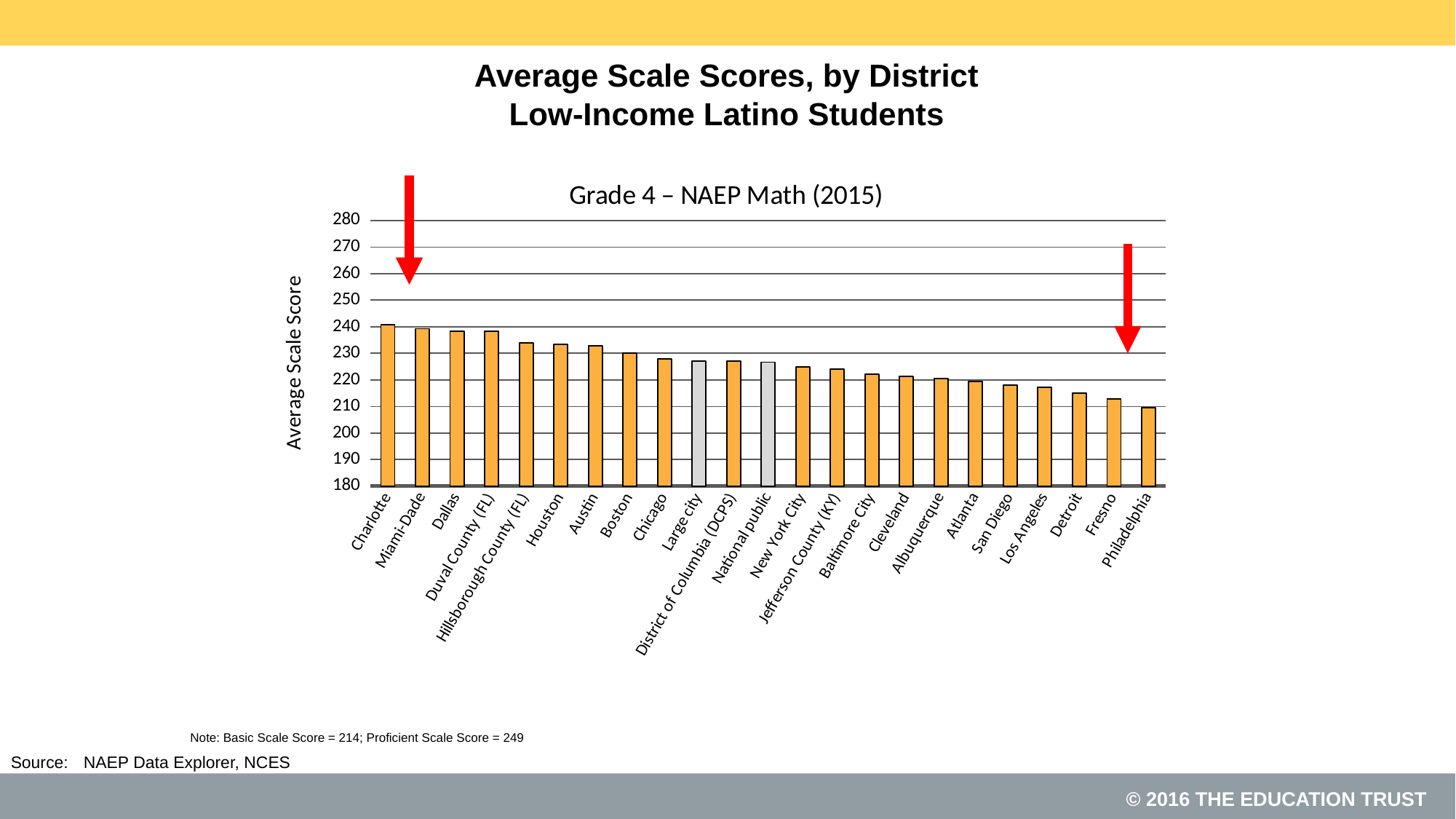
Which district has the highest average scale score? Charlotte Is the value for Dallas greater or less than 230? greater Which district has the lowest average scale score? Philadelphia Which two bars are shaded grey instead of orange? Large city and National public Is the value for Houston greater or less than 230? greater Is the value for Fresno greater or less than 220? less How many districts or groups are plotted along the x axis? 23 Which has a higher average scale score, Houston or Detroit? Houston Do the values rise or fall moving from left to right along the x axis? Fall What kind of chart is shown on the slide? Bar chart What is the subtitle shown above the chart's plot area? Grade 4 – NAEP Math (2015)